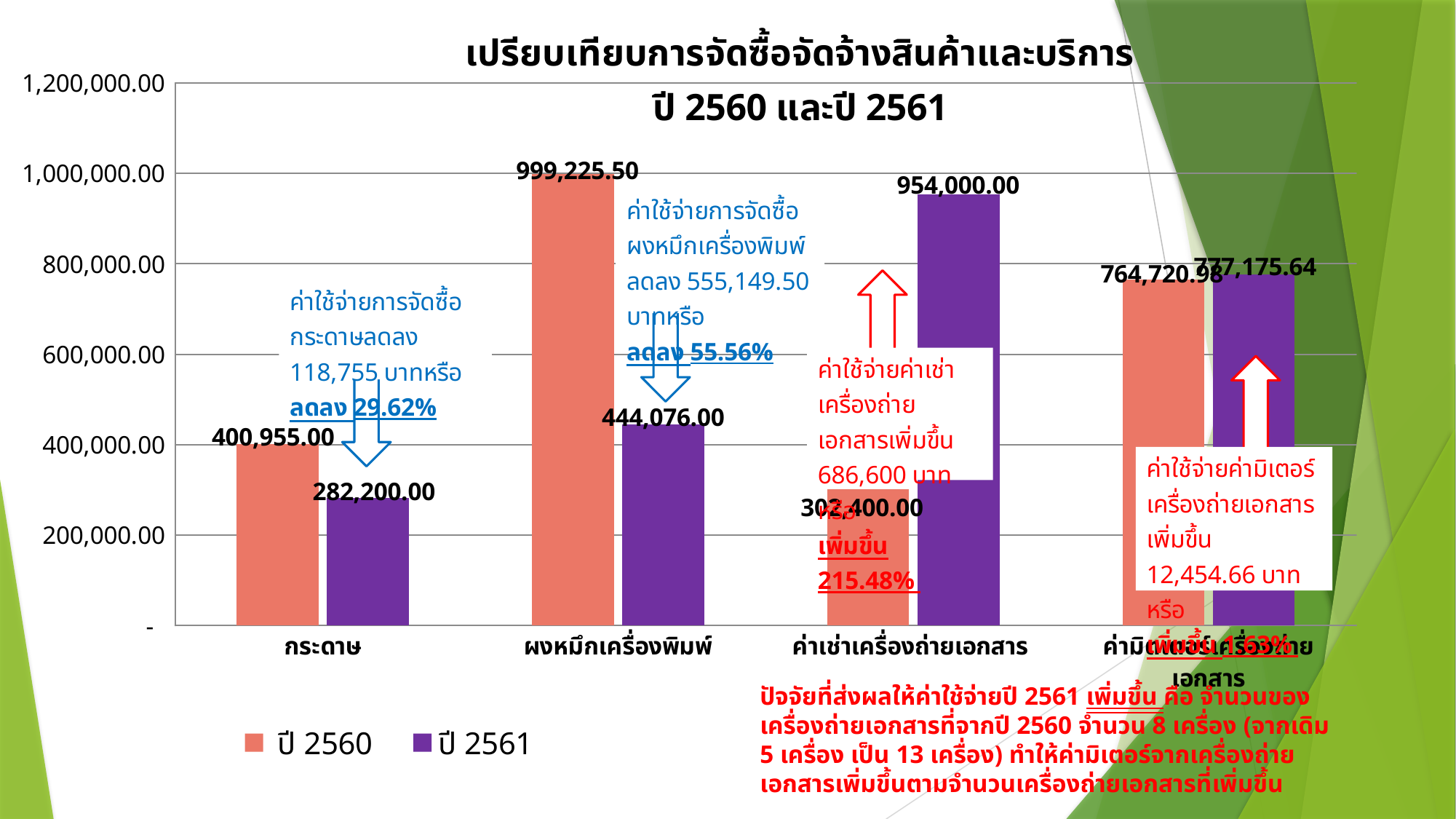
What is the value for ค่าเช่าเครื่องถ่ายเอกสาร in the ปี 2561 series? 954,000.00 Which category has the highest value in the ปี 2561 series? ค่าเช่าเครื่องถ่ายเอกสาร What kind of chart is shown on the slide? bar chart Is the ปี 2561 value for ค่ามิเตอร์เครื่องถ่ายเอกสาร greater or less than 600,000.00? greater What is the value for ผงหมึกเครื่องพิมพ์ in the ปี 2561 series? 444,076.00 Which category has the lowest value in the ปี 2561 series? กระดาษ How many categories are shown on the x axis of the chart? 4 What is the value for ผงหมึกเครื่องพิมพ์ in the ปี 2560 series? 999,225.50 How many series does the chart legend list? 2 For ค่าเช่าเครื่องถ่ายเอกสาร, which series has the larger value, ปี 2560 or ปี 2561? ปี 2561 What is the value for กระดาษ in the ปี 2560 series? 400,955.00 What is the difference between the ปี 2560 and ปี 2561 values for ผงหมึกเครื่องพิมพ์? 555,149.50